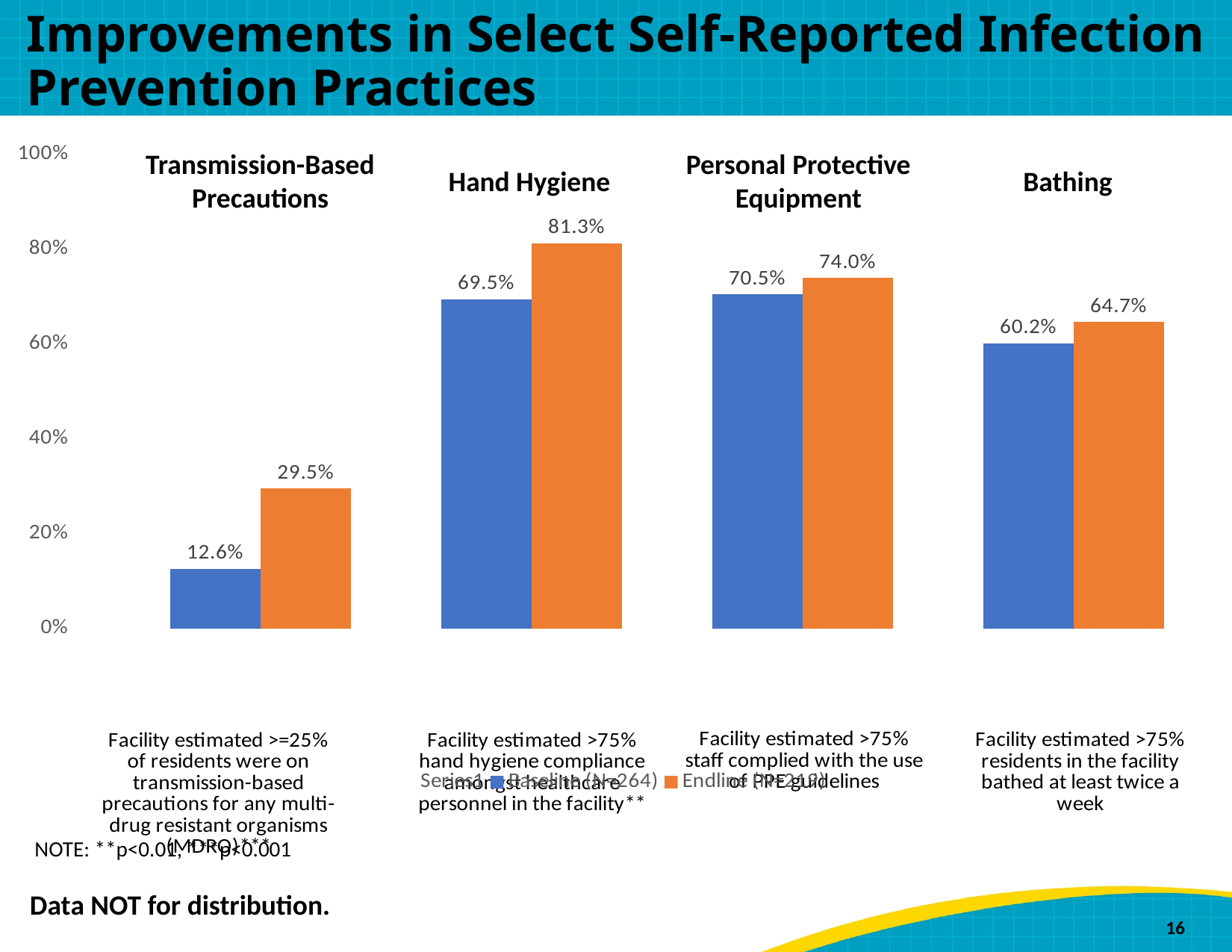
Which is larger: the blue bar for Personal Protective Equipment or the blue bar for Bathing? Personal Protective Equipment How many categories are shown on the chart? 4 What is the value of the orange bar for Bathing? 64.7% Which category has the highest orange (Endline) bar? Hand Hygiene Which category has the lowest blue (Baseline) bar? Transmission-Based Precautions What is the difference between the orange and blue bars for Transmission-Based Precautions? 16.9% What kind of chart is shown on the slide? Bar chart Is the orange bar for Transmission-Based Precautions greater or less than 40%? less What is the value of the blue bar for Personal Protective Equipment? 70.5% What is the difference between the orange and blue bars for Hand Hygiene? 11.8% What is the value of the orange (Endline) bar for Hand Hygiene? 81.3% What is the value of the blue (Baseline) bar for Transmission-Based Precautions? 12.6%